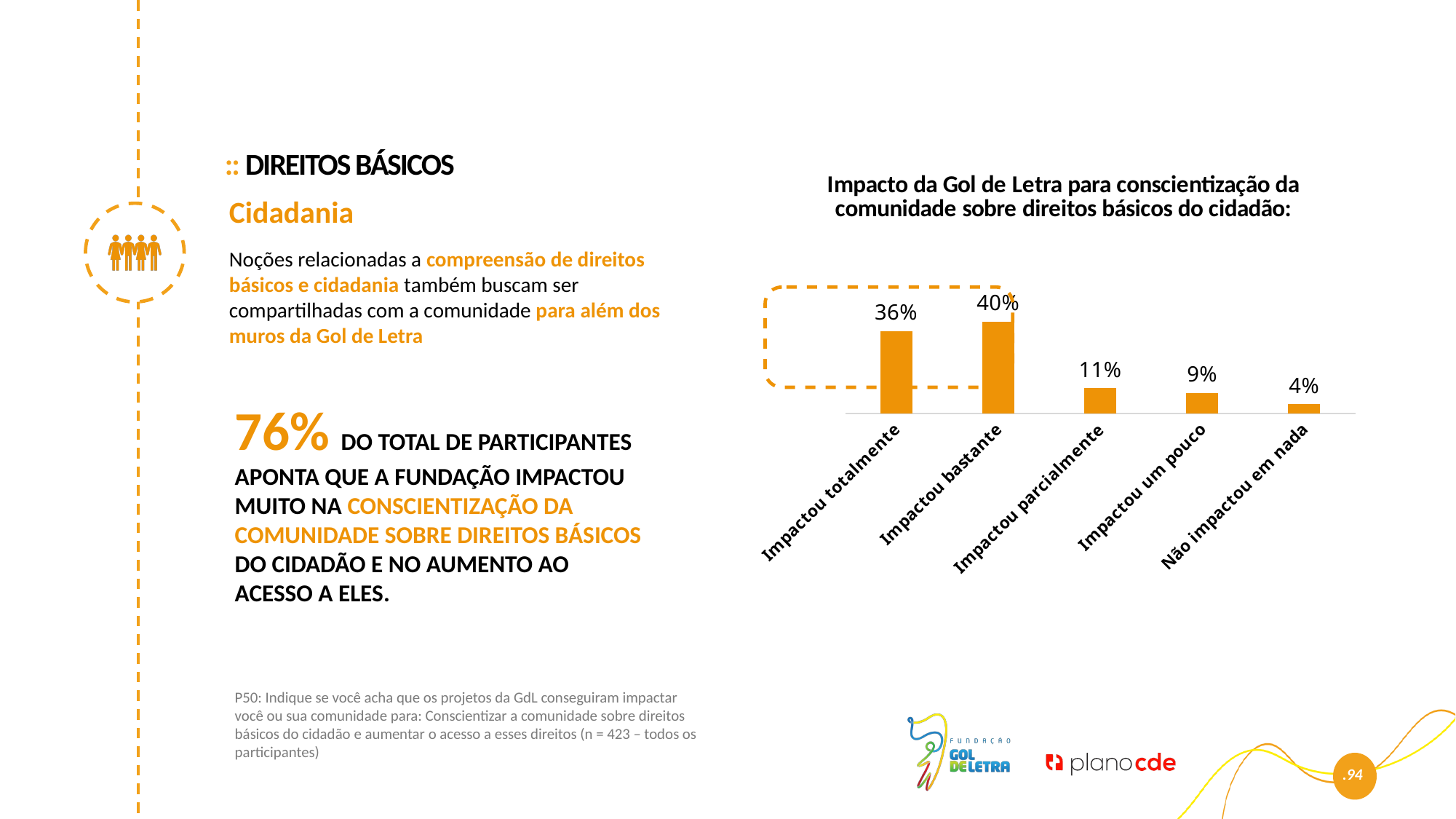
Which category has the lowest value? Não impactou em nada How many categories are shown in the chart? 5 What is the title of the chart? Impacto da Gol de Letra para conscientização da comunidade sobre direitos básicos do cidadão: What is the value for "Impactou bastante"? 40% Which is larger, the value for "Impactou parcialmente" or "Impactou um pouco"? Impactou parcialmente Do the values rise or fall from left to right after "Impactou bastante"? Fall What is the value for "Impactou totalmente"? 36% What is the value for "Não impactou em nada"? 4% What is the difference between the values for "Impactou bastante" and "Impactou totalmente"? 4% What is the value for "Impactou parcialmente"? 11% What kind of chart is shown on the slide? Bar chart Which category has the highest value? Impactou bastante